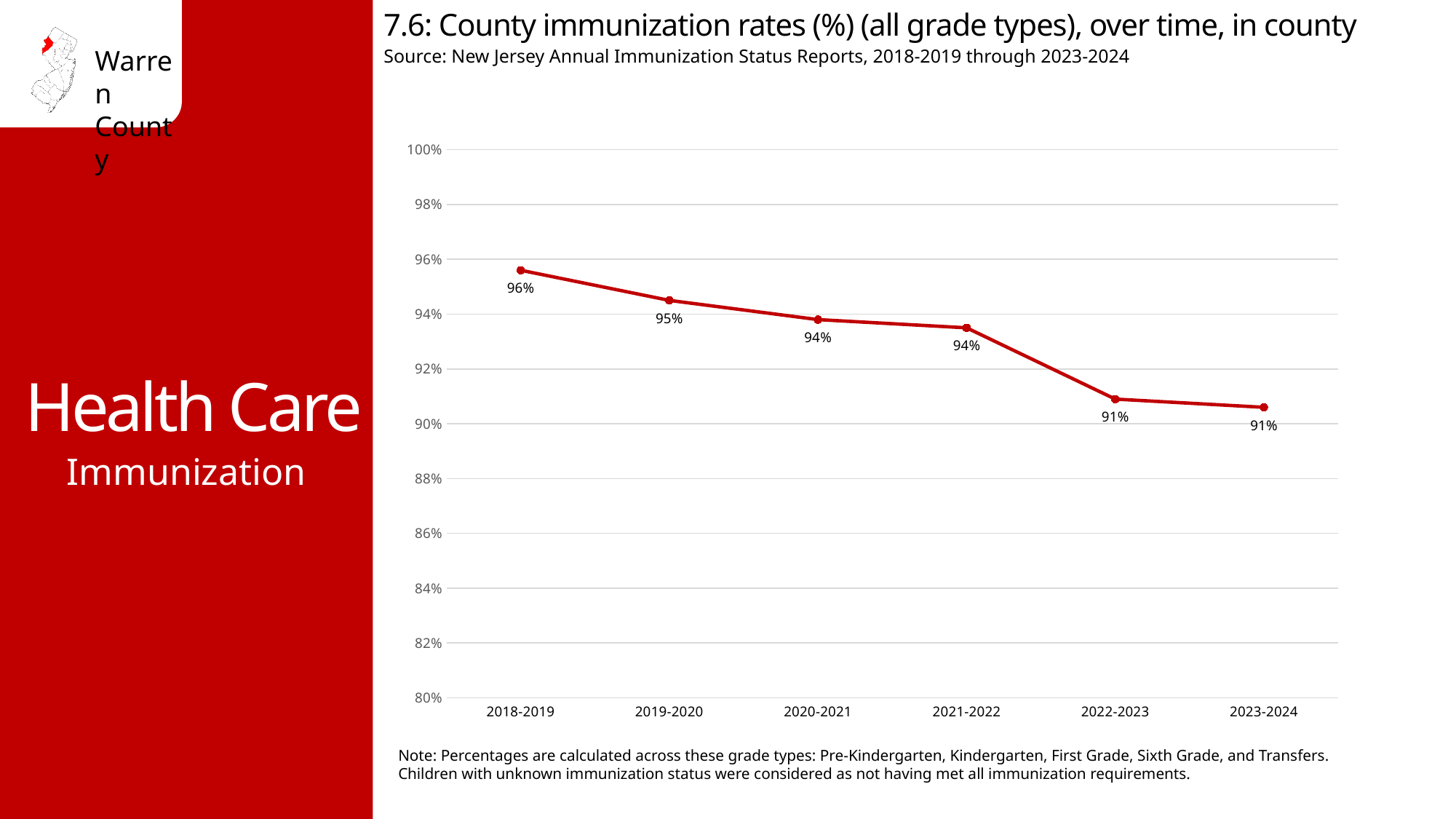
Which is larger, the immunization rate in 2019-2020 or in 2022-2023? 2019-2020 What is the difference between the immunization rate in 2018-2019 and in 2023-2024, using the printed labels? 5% What is the county immunization rate for 2021-2022? 94% What kind of chart is shown on the slide? line chart Do the immunization rates rise or fall from 2018-2019 to 2023-2024? fall What is the county immunization rate for 2023-2024? 91% Which school year has the highest immunization rate? 2018-2019 Is the immunization rate for 2020-2021 greater or less than 92%? greater What is the county immunization rate for 2019-2020? 95% What is the county immunization rate for 2018-2019? 96% How many school years are plotted on the chart? 6 Is the immunization rate for 2022-2023 greater or less than 92%? less